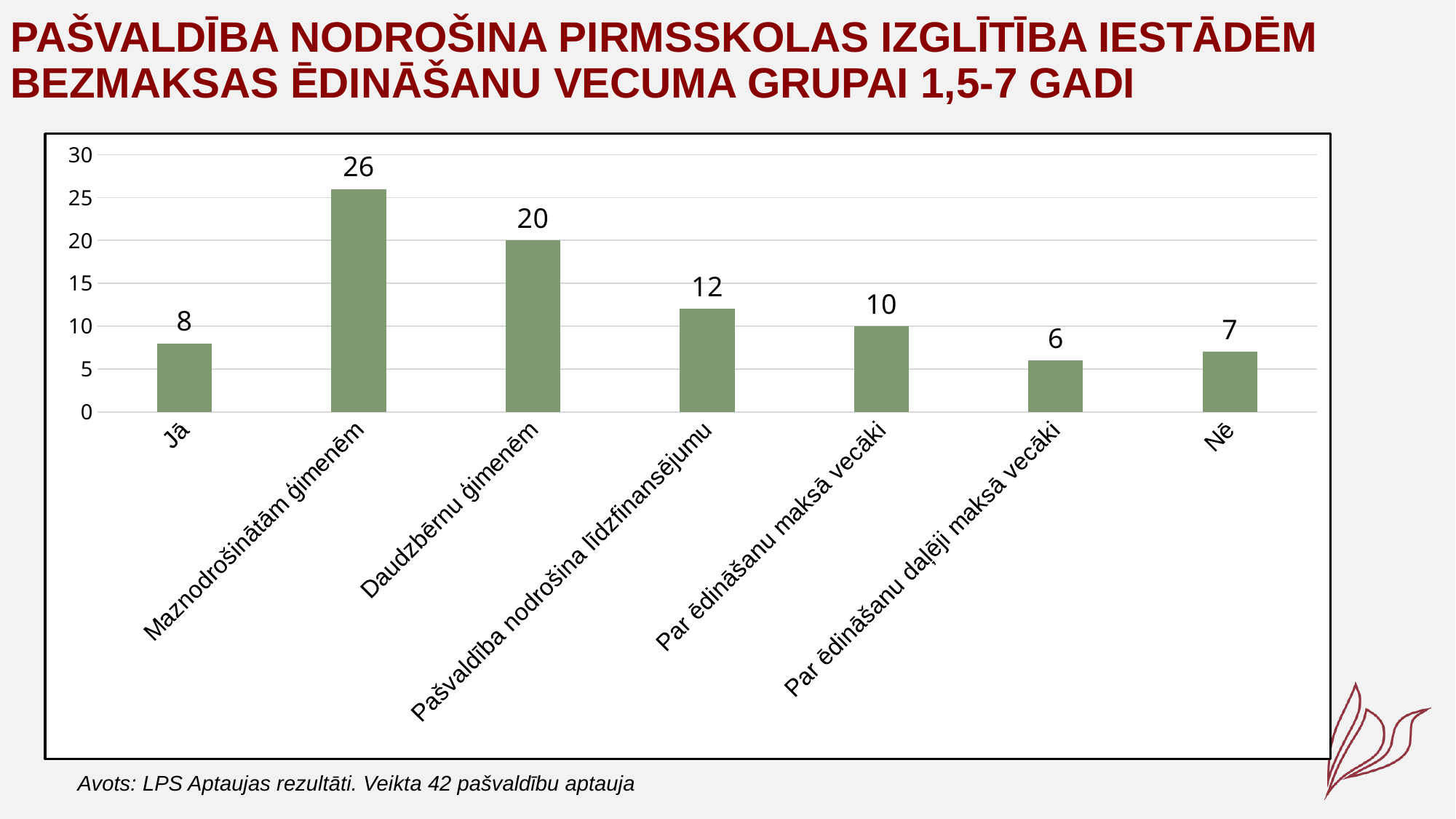
Which category has the lowest value? Par ēdināšanu daļēji maksā vecāki What is the value for "Jā"? 8 What kind of chart is shown on the slide? Bar chart What is the value for "Nē"? 7 How many categories are shown on the x axis? 7 Which category has the highest value? Maznodrošinātām ģimenēm What is the value for "Pašvaldība nodrošina līdzfinansējumu"? 12 What is the value for "Daudzbērnu ģimenēm"? 20 What is the difference between the values for "Maznodrošinātām ģimenēm" and "Daudzbērnu ģimenēm"? 6 Which is larger, the value for "Par ēdināšanu maksā vecāki" or the value for "Par ēdināšanu daļēji maksā vecāki"? Par ēdināšanu maksā vecāki What is the value for "Maznodrošinātām ģimenēm"? 26 What is the source stated below the chart? LPS Aptaujas rezultāti. Veikta 42 pašvaldību aptauja